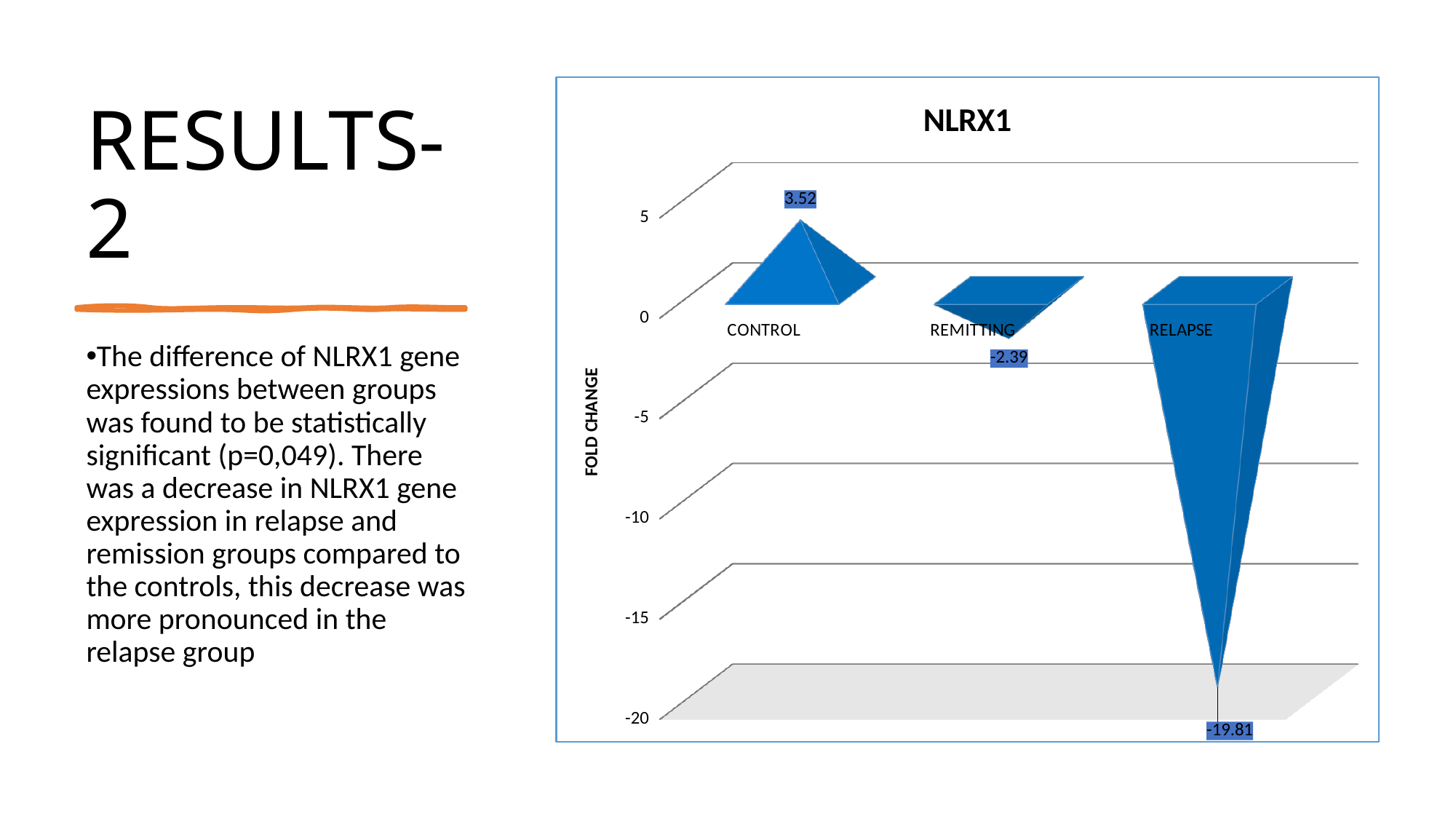
Which has a larger fold change, REMITTING or RELAPSE? REMITTING What is the fold change value for REMITTING? -2.39 Which category has the lowest fold change? RELAPSE What is the fold change value for RELAPSE? -19.81 What is the fold change value for CONTROL? 3.52 What is the difference between the fold change for CONTROL and REMITTING? 5.91 What is the difference between the fold change for REMITTING and RELAPSE? 17.42 What type of chart is shown? bar chart What is the title of the chart? NLRX1 How many categories are shown on the chart? 3 Which category has the highest fold change? CONTROL Is the value for RELAPSE greater or less than -15? less